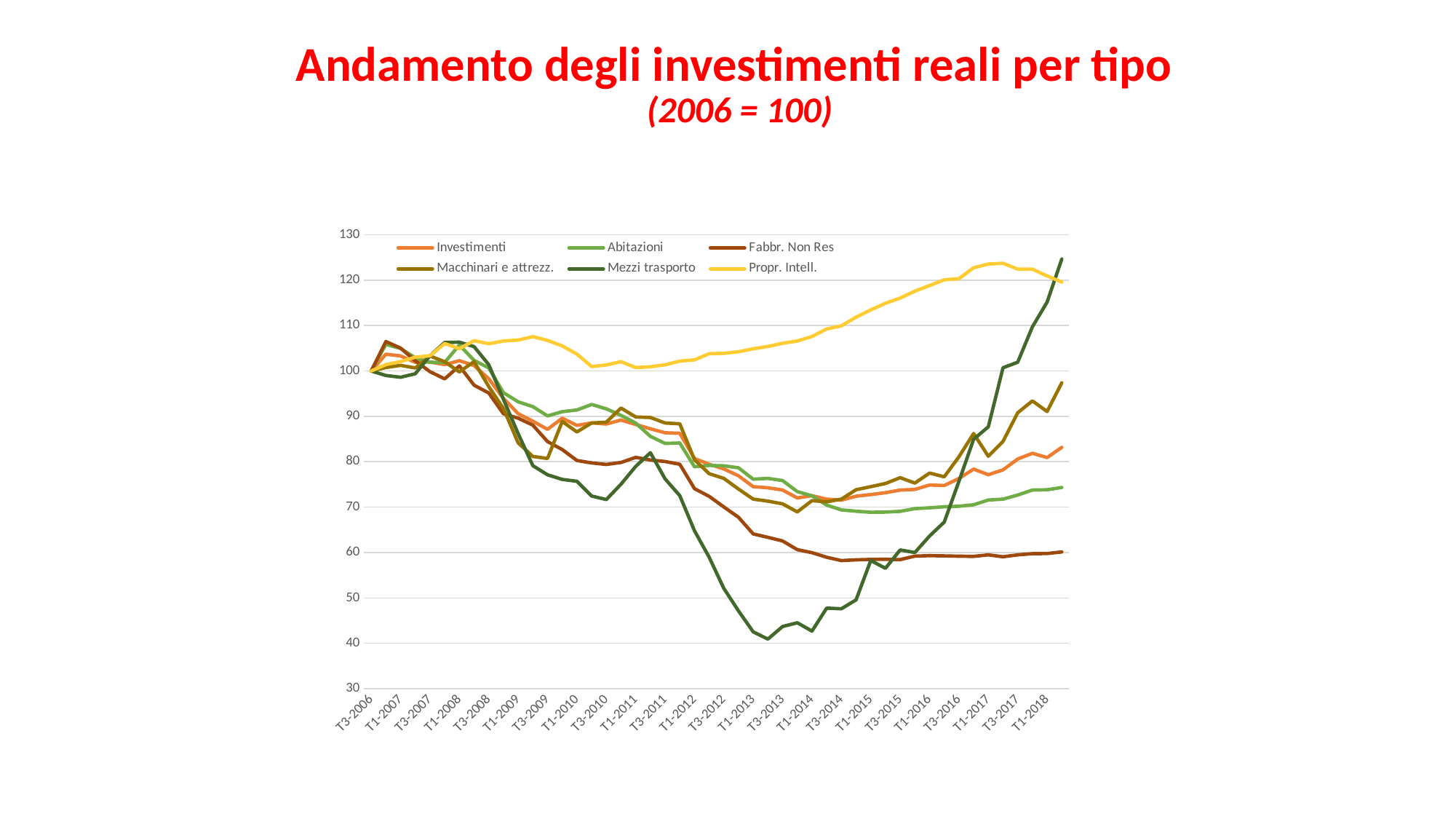
What is the title of the chart on the slide? Andamento degli investimenti reali per tipo (2006 = 100) How many series does the legend list? 6 What kind of chart is shown on the slide? line chart Which series is the lowest at T3-2013? Mezzi trasporto Does the Propr. Intell. series rise or fall between T1-2013 and T1-2017? rise At T1-2018, which is larger: Propr. Intell. or Abitazioni? Propr. Intell. Is the value for Mezzi trasporto at T3-2013 greater or less than 50? less Is the value for Propr. Intell. at T1-2017 greater or less than 120? greater Which series is the lowest at T1-2018? Fabbr. Non Res Which series is the highest at T1-2017? Propr. Intell. Does the Fabbr. Non Res series rise or fall between T1-2008 and T1-2014? fall